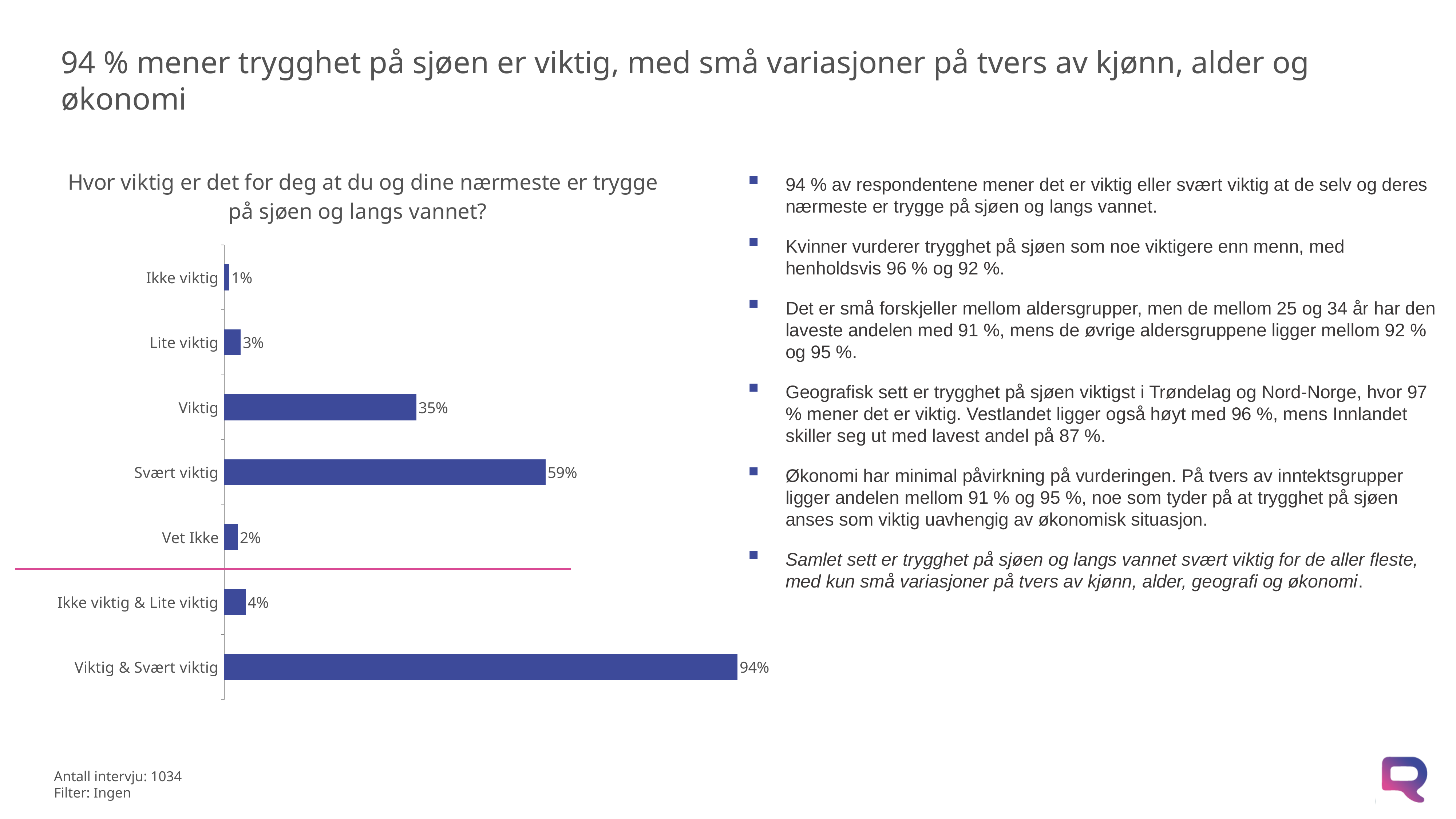
Which category has the lowest value? Ikke viktig How many categories are shown in the chart? 7 What is the title of the chart? Hvor viktig er det for deg at du og dine nærmeste er trygge på sjøen og langs vannet? What kind of chart is shown? Bar chart What is the value for "Viktig & Svært viktig"? 94% What is the value for "Viktig"? 35% What is the value for "Ikke viktig"? 1% Which is larger, "Lite viktig" or "Ikke viktig & Lite viktig"? Ikke viktig & Lite viktig What is the value for "Svært viktig"? 59% Which category has the highest value? Viktig & Svært viktig What is the value for "Vet Ikke"? 2% What is the difference between "Svært viktig" and "Viktig"? 24%